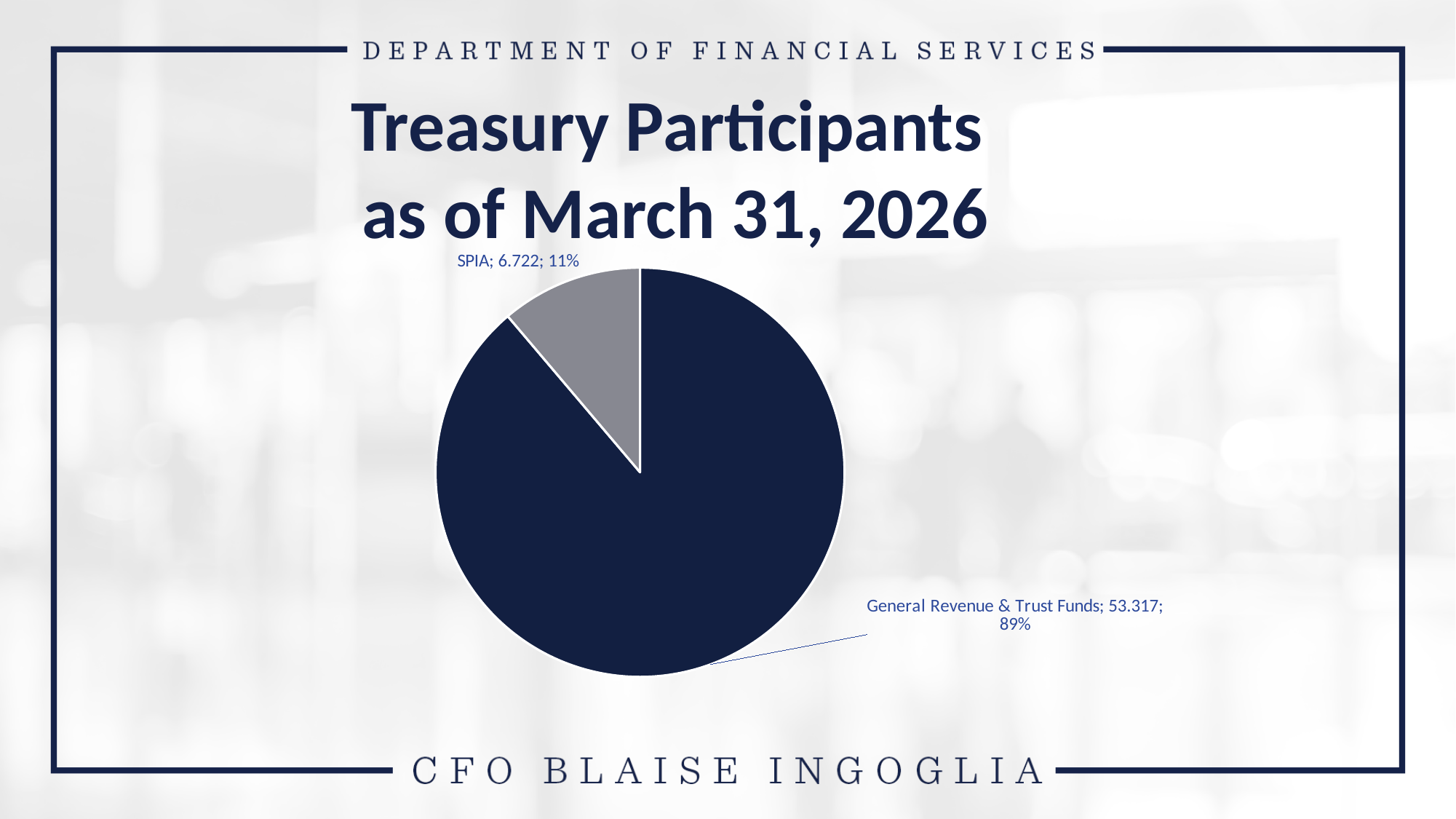
What kind of chart is shown on the slide? pie chart What share of the pie does General Revenue & Trust Funds represent? 89% What is the title of the chart? Treasury Participants as of March 31, 2026 What colour is the SPIA slice? grey How many slices does the pie chart have? 2 Which is larger, SPIA or General Revenue & Trust Funds? General Revenue & Trust Funds What is the difference between the General Revenue & Trust Funds value and the SPIA value? 46.595 What share of the pie does SPIA represent? 11% Which slice is the largest? General Revenue & Trust Funds What is the value for SPIA? 6.722 What is the value for General Revenue & Trust Funds? 53.317 Which slice is the smallest? SPIA